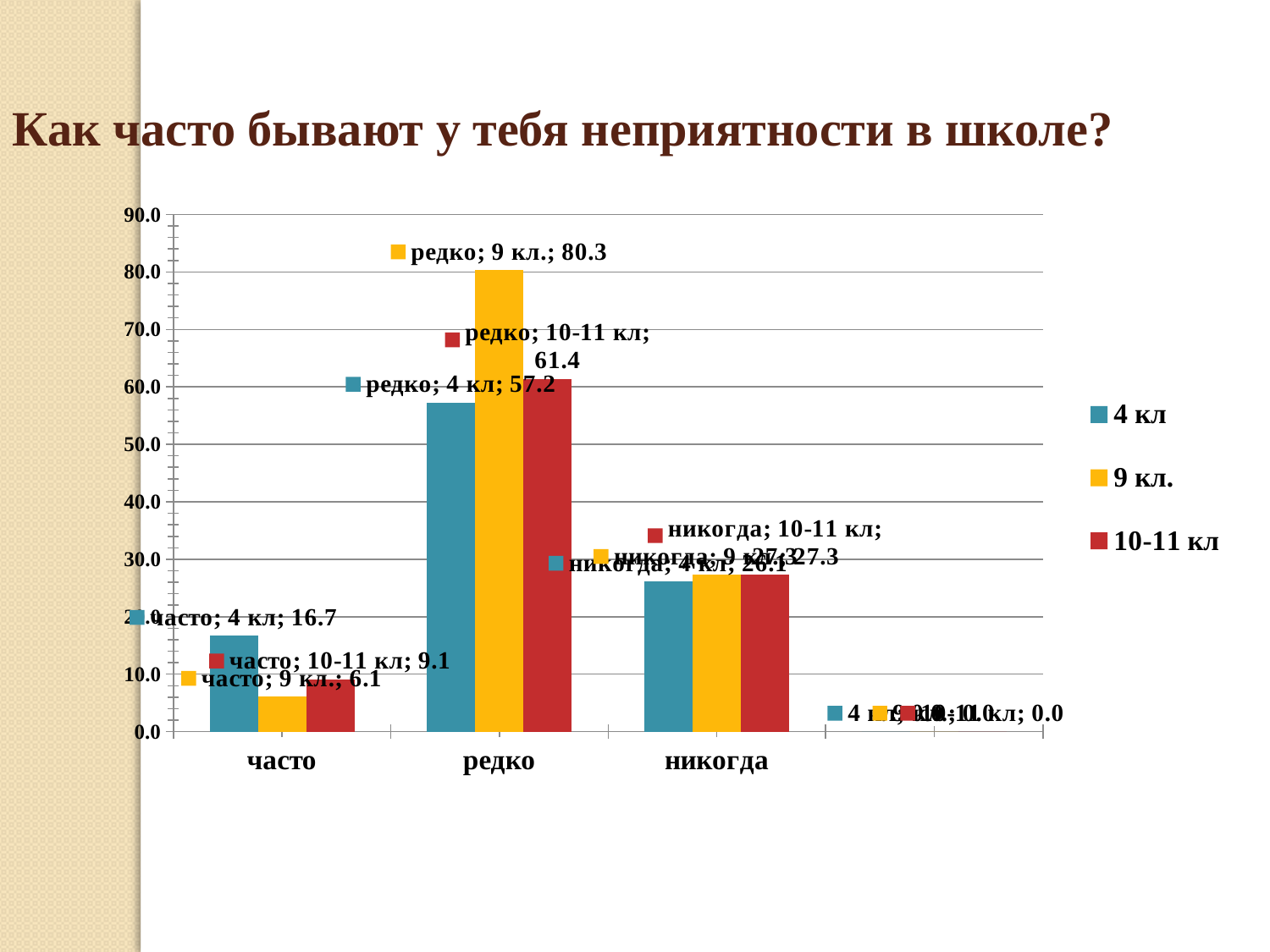
For the 9 кл. series, which category has the highest value? редко Is the value for 4 кл in the никогда category greater or less than 30? less What is the value for 4 кл in the часто category? 16.7 What is the value for 10-11 кл in the редко category? 61.4 What is the value for 9 кл. in the часто category? 6.1 What is the title of the chart? Как часто бывают у тебя неприятности в школе? In the часто category, which series has the lowest value? 9 кл. What is the value for 9 кл. in the редко category? 80.3 In the редко category, how much higher is the value for 9 кл. than for 4 кл? 23.1 In the редко category, which is larger: the value for 4 кл or for 10-11 кл? 10-11 кл How many series does the legend list? 3 What kind of chart is shown on the slide? bar chart